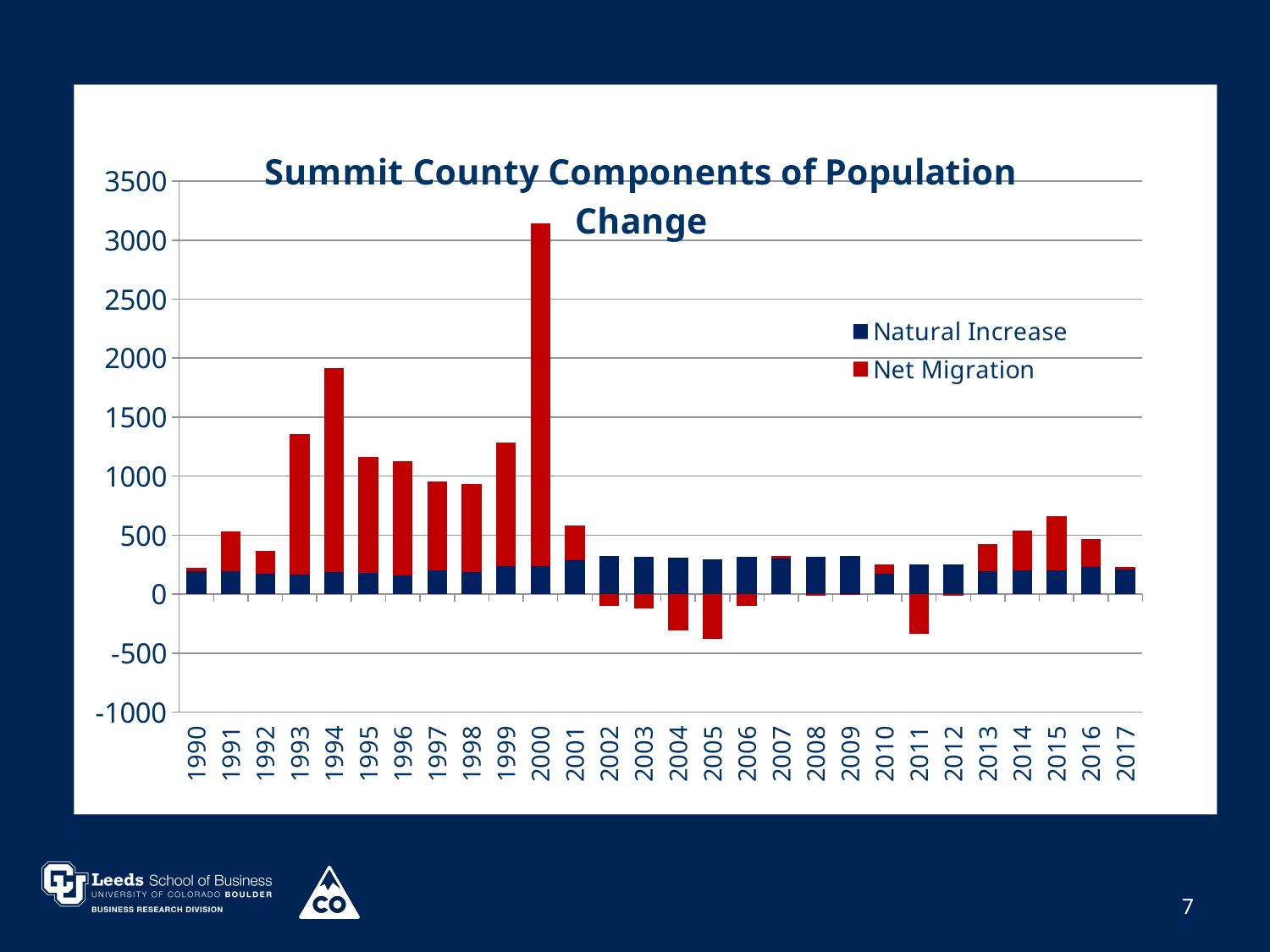
In which year is Net Migration highest? 2000 Between 2013 and 2015, does Net Migration rise or fall? rise What kind of chart is shown on the slide? Stacked bar chart Is the Net Migration value for 2005 greater or less than 0? less What is the title of the chart? Summit County Components of Population Change Is the Natural Increase value for 2001 greater or less than 500? less How many years are shown on the x axis? 28 Which year has the larger Net Migration, 1993 or 1994? 1994 How many series does the legend list? 2 Is the Net Migration value for 1994 greater or less than 1500? greater Which series is shown in red? Net Migration